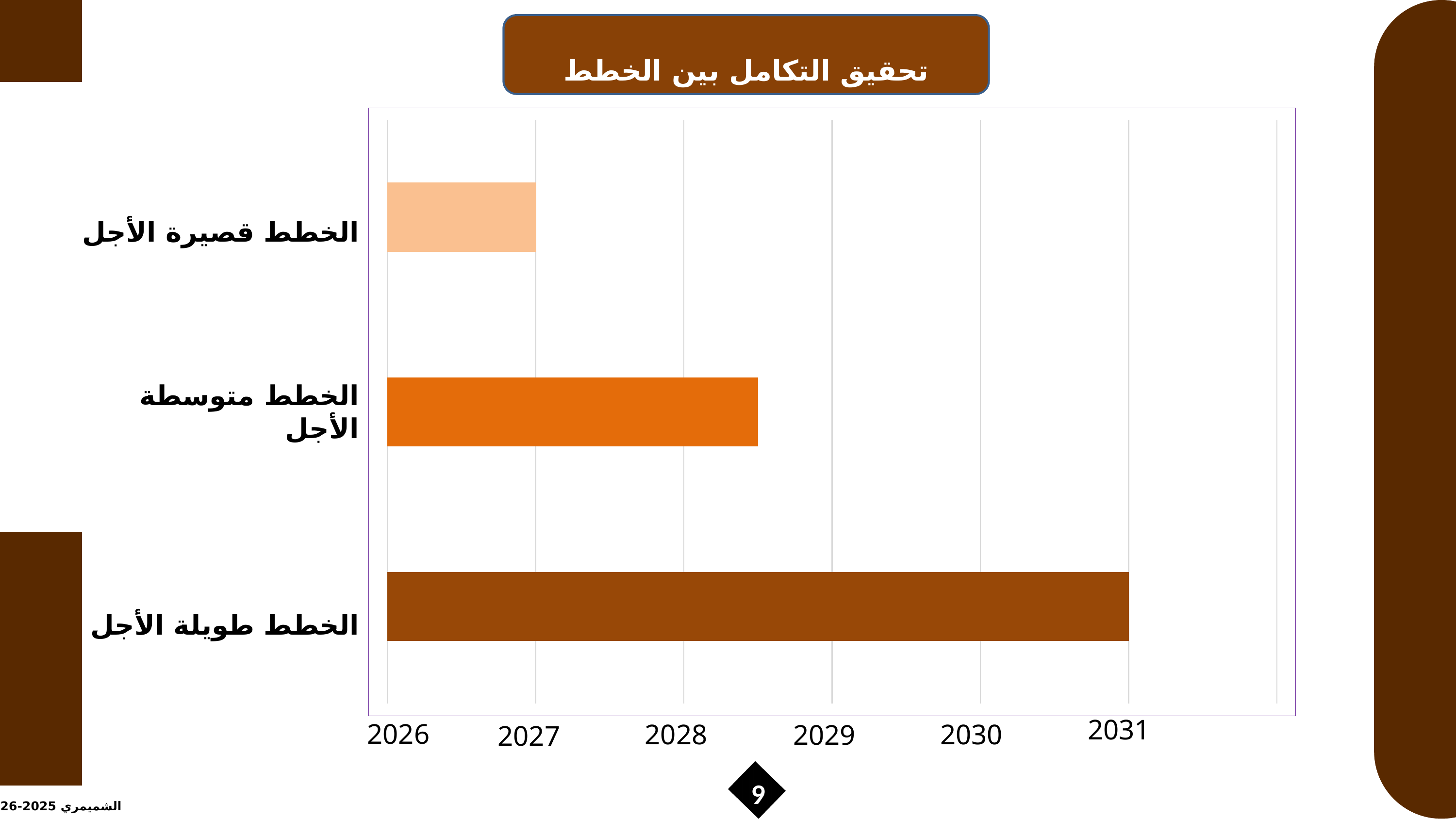
What kind of chart is shown on the slide? bar chart How many years longer does the bar for الخطط طويلة الأجل extend than the bar for الخطط قصيرة الأجل? 4 What is the title of the chart on the slide? تحقيق التكامل بين الخطط What are the first and last years shown on the horizontal axis of the chart? 2026 and 2031 How many categories are plotted in the chart? 3 Which bar is longer: الخطط متوسطة الأجل or الخطط قصيرة الأجل? الخطط متوسطة الأجل At which year does the bar for الخطط طويلة الأجل end? 2031 At which year does the bar for الخطط قصيرة الأجل end? 2027 Which category has the shortest bar in the chart? الخطط قصيرة الأجل Does the bar for الخطط متوسطة الأجل end before or after 2028? after Which category has the longest bar in the chart? الخطط طويلة الأجل Does the bar for الخطط متوسطة الأجل end before or after 2029? before